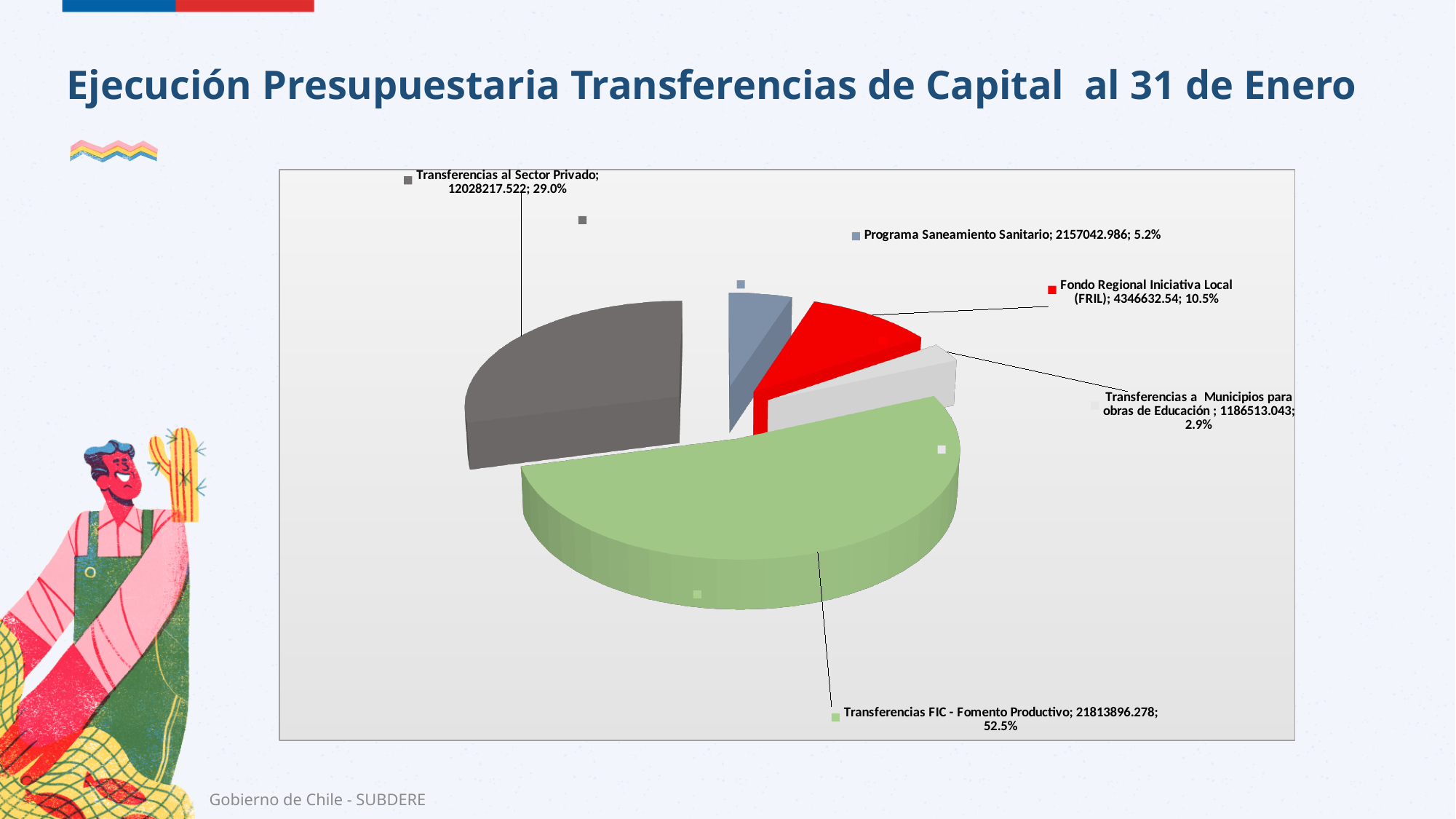
How many slices does the pie chart have? 5 What is the difference in percentage share between Transferencias FIC - Fomento Productivo and Transferencias al Sector Privado? 23.5% What percentage share does Fondo Regional Iniciativa Local (FRIL) have? 10.5% What is the value shown for Transferencias FIC - Fomento Productivo? 21813896.278 Which has a larger share: Programa Saneamiento Sanitario or Fondo Regional Iniciativa Local (FRIL)? Fondo Regional Iniciativa Local (FRIL) What kind of chart is shown on the slide? Pie chart What is the value shown for Transferencias a Municipios para obras de Educación? 1186513.043 What percentage share does Transferencias al Sector Privado have? 29.0% What is the value shown for Programa Saneamiento Sanitario? 2157042.986 Which category has the smallest share of the pie? Transferencias a Municipios para obras de Educación Which category has the largest share of the pie? Transferencias FIC - Fomento Productivo What is the title of the slide containing the chart? Ejecución Presupuestaria Transferencias de Capital al 31 de Enero